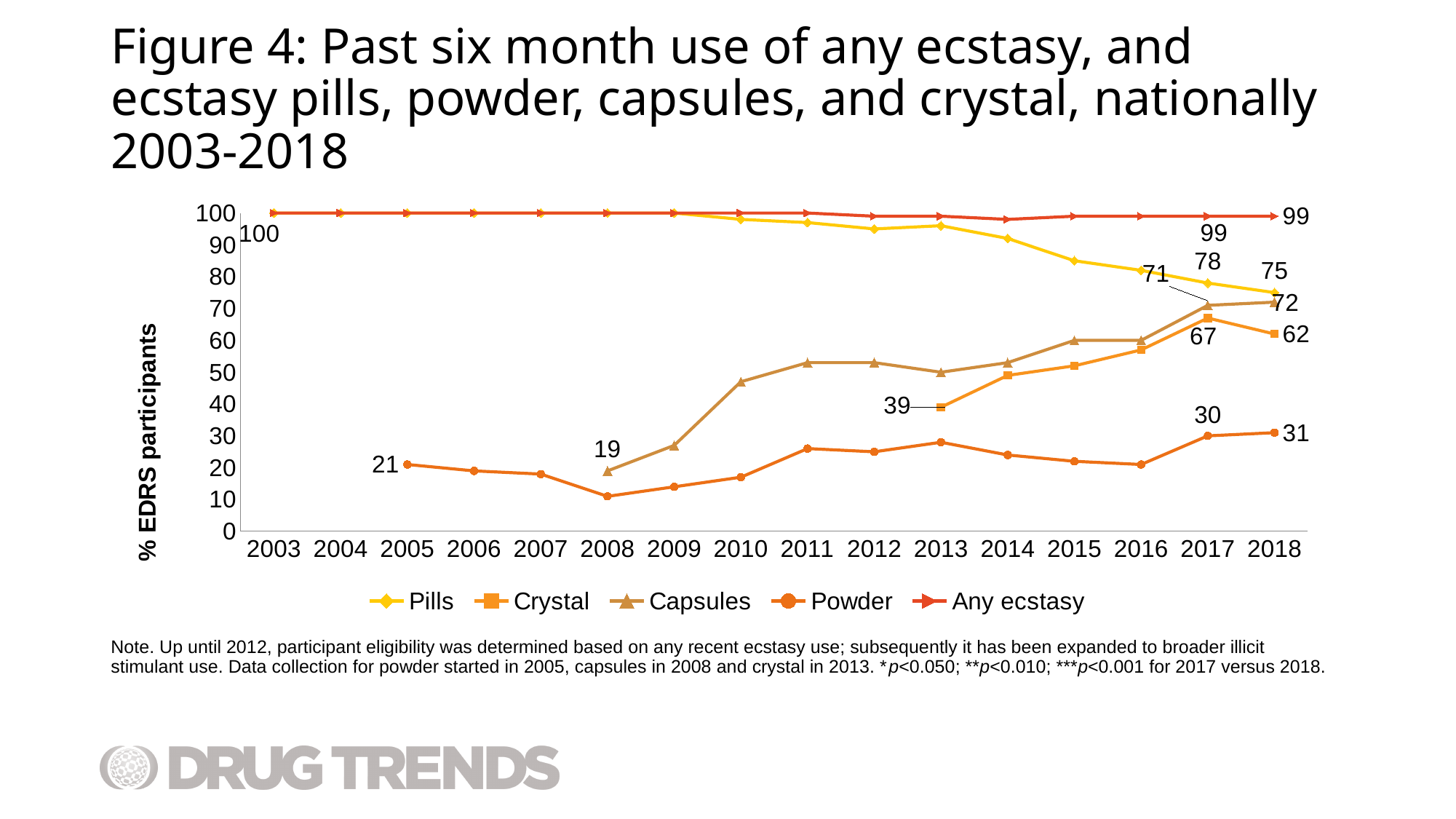
What is the value for Crystal in 2013? 39 In 2018, which is larger: Capsules or Crystal? Capsules Is the value for Powder in 2008 greater or less than 20? less What is the value for Capsules in 2008? 19 Which series has the lowest value in 2018? Powder How many years are shown on the x axis? 16 By how much did the Pills value fall from 2017 to 2018? 3 What is the value for Powder in 2005? 21 How many series does the legend list? 5 What is the value for Pills in 2018? 75 What kind of chart is shown on the slide? Line chart Does the Pills series rise or fall from 2003 to 2018? Fall